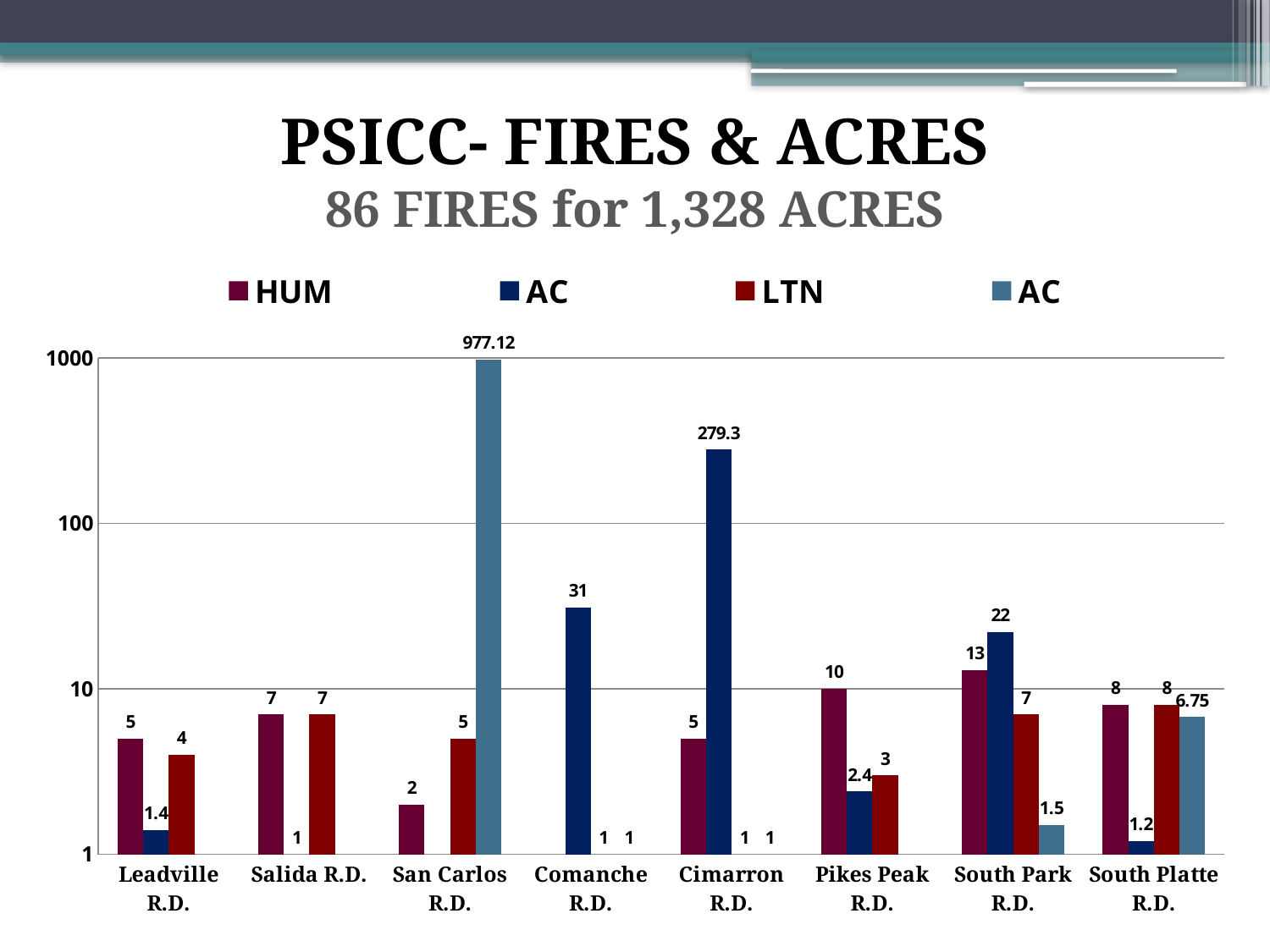
Which district has the highest HUM value? South Park R.D. What is the dark blue AC value for Cimarron R.D.? 279.3 What is the LTN value for South Park R.D.? 7 What is the subtitle shown under the chart title? 86 FIRES for 1,328 ACRES How many series does the legend list? 4 What is the difference between the dark blue AC value and the HUM value for South Park R.D.? 9 Which is larger for Leadville R.D., the HUM value or the LTN value? HUM How many ranger districts are shown on the x axis? 8 What kind of chart is shown on the slide? bar chart Which district has the highest dark blue AC value? Cimarron R.D. What is the light blue AC value for San Carlos R.D.? 977.12 What is the HUM value for Pikes Peak R.D.? 10